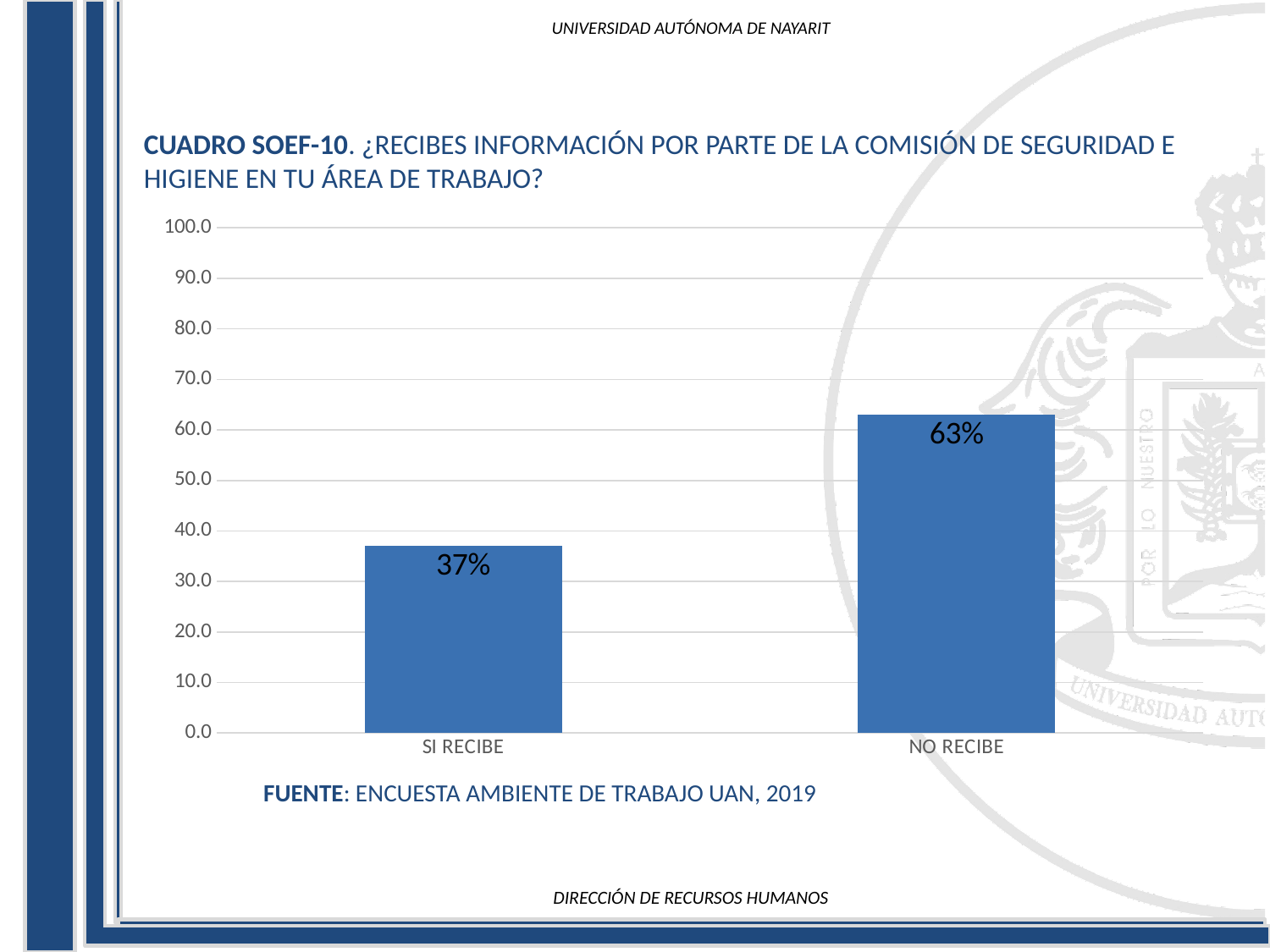
Is the value for NO RECIBE greater or less than 50.0? greater Which category has the lowest value? SI RECIBE What is the value for NO RECIBE? 63% What is the maximum value shown on the y axis? 100.0 Which category has the highest value? NO RECIBE What is the difference between the values for NO RECIBE and SI RECIBE? 26% What is the value for SI RECIBE? 37% Is the value for SI RECIBE greater or less than 40.0? less What kind of chart is shown on the slide? bar chart Which is larger, the value for SI RECIBE or the value for NO RECIBE? NO RECIBE How many categories are shown on the x axis? 2 What source is cited below the chart? ENCUESTA AMBIENTE DE TRABAJO UAN, 2019